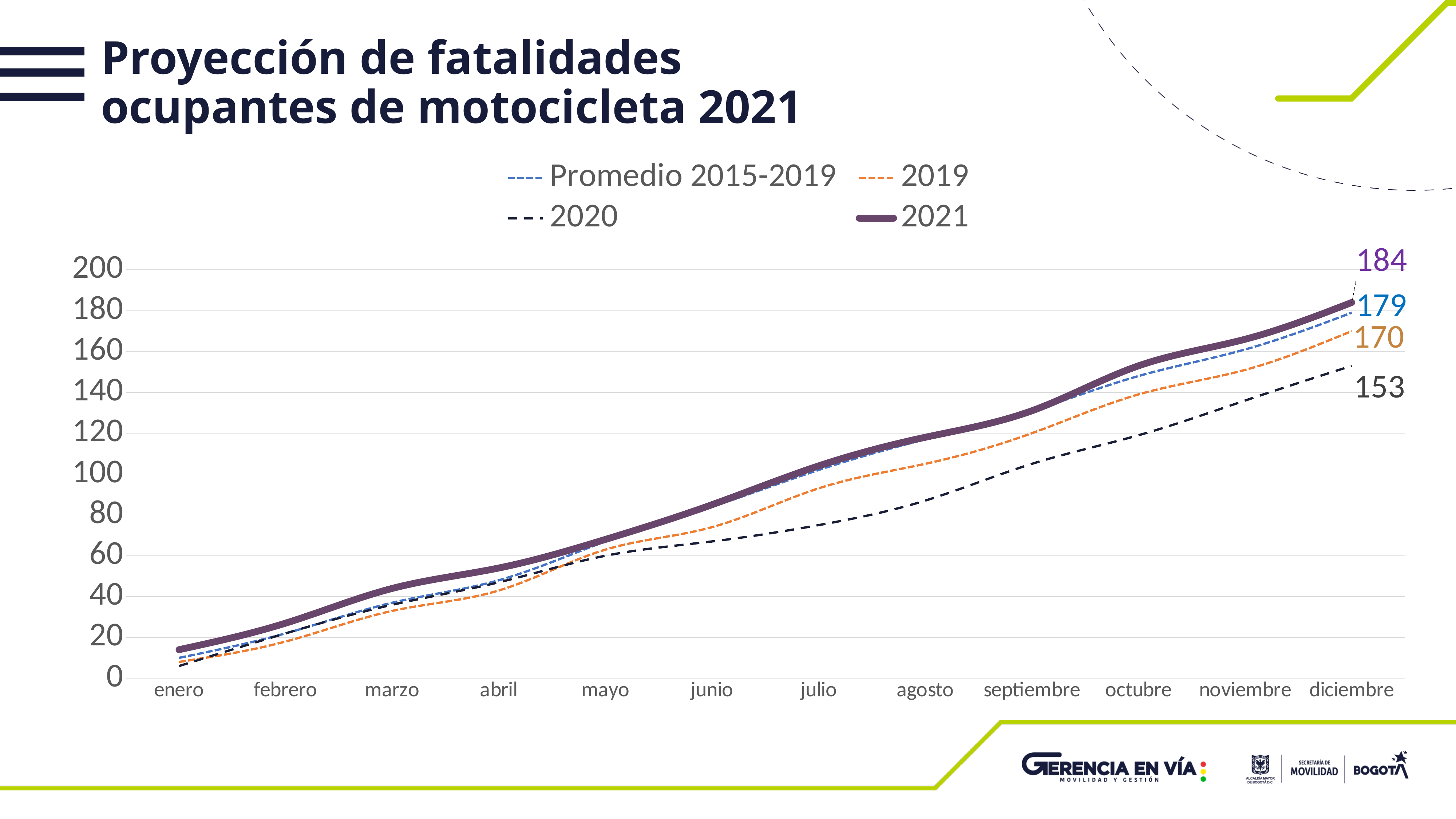
Which series has the lowest value in diciembre? 2020 What is the difference between the 2021 and 2020 values in diciembre? 31 Which series has the highest value in diciembre? 2021 How many series does the legend list? 4 What is the value for Promedio 2015-2019 in diciembre? 179 What kind of chart is shown on the slide? line chart Which is larger in diciembre, the value for 2019 or the value for Promedio 2015-2019? Promedio 2015-2019 What is the value for 2021 in diciembre? 184 How many months are shown on the x axis? 12 What is the value for 2019 in diciembre? 170 Is the value for 2020 in agosto greater or less than 100? less What is the value for 2020 in diciembre? 153